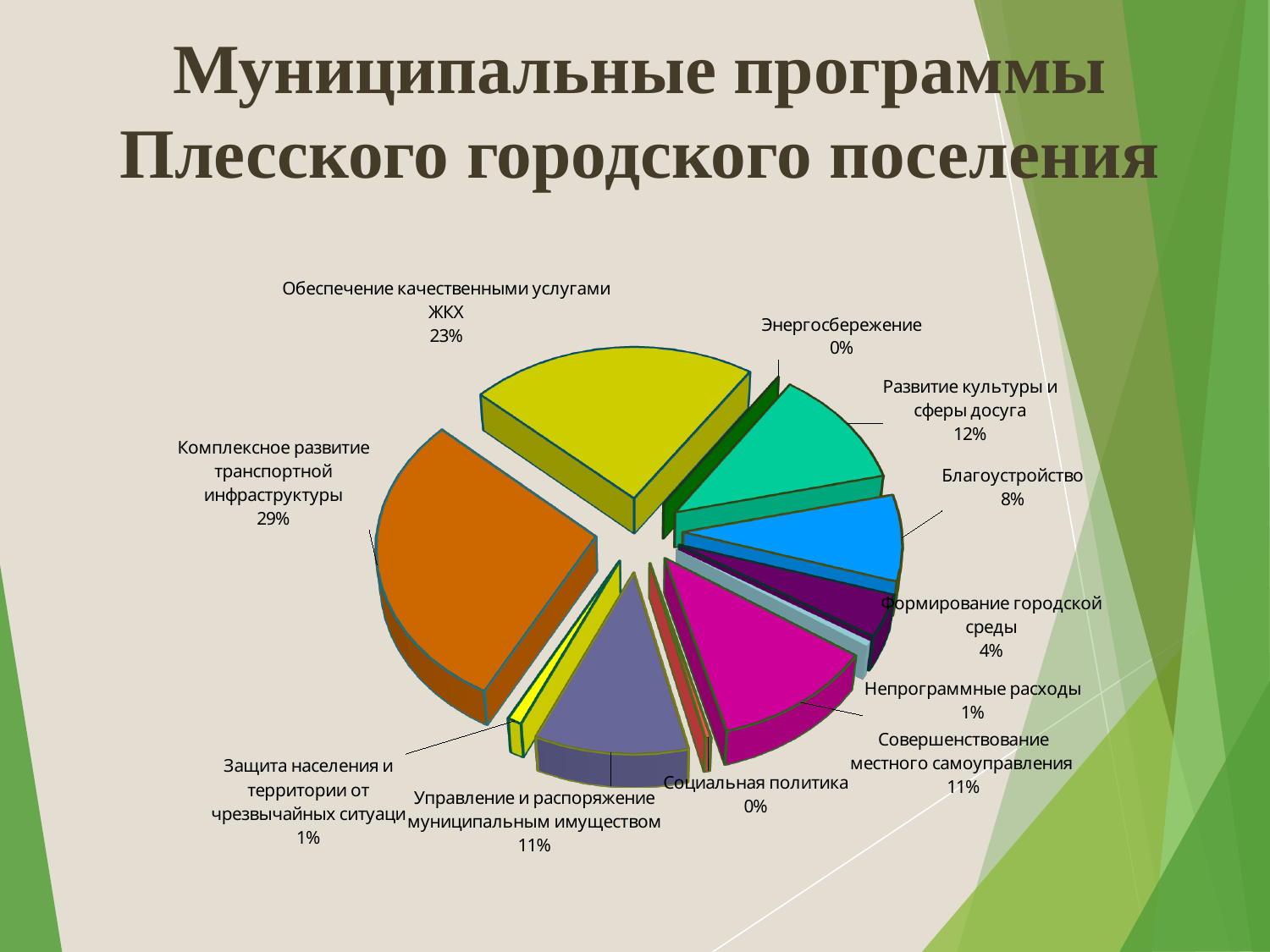
What percentage is shown for "Развитие культуры и сферы досуга"? 12% Which has a larger share: "Развитие культуры и сферы досуга" or "Благоустройство"? Развитие культуры и сферы досуга What percentage is shown for "Формирование городской среды"? 4% Which category has the largest share of the pie? Комплексное развитие транспортной инфраструктуры What is the title of the slide? Муниципальные программы Плесского городского поселения What percentage is shown for "Благоустройство"? 8% What kind of chart is shown on the slide? Pie chart What percentage is shown for "Обеспечение качественными услугами ЖКХ"? 23% What is the difference in percentage points between "Комплексное развитие транспортной инфраструктуры" and "Обеспечение качественными услугами ЖКХ"? 6 percentage points What share of the pie does "Комплексное развитие транспортной инфраструктуры" have? 29% Which two categories are shown with 0%? Энергосбережение and Социальная политика How many categories are shown in the pie chart? 11